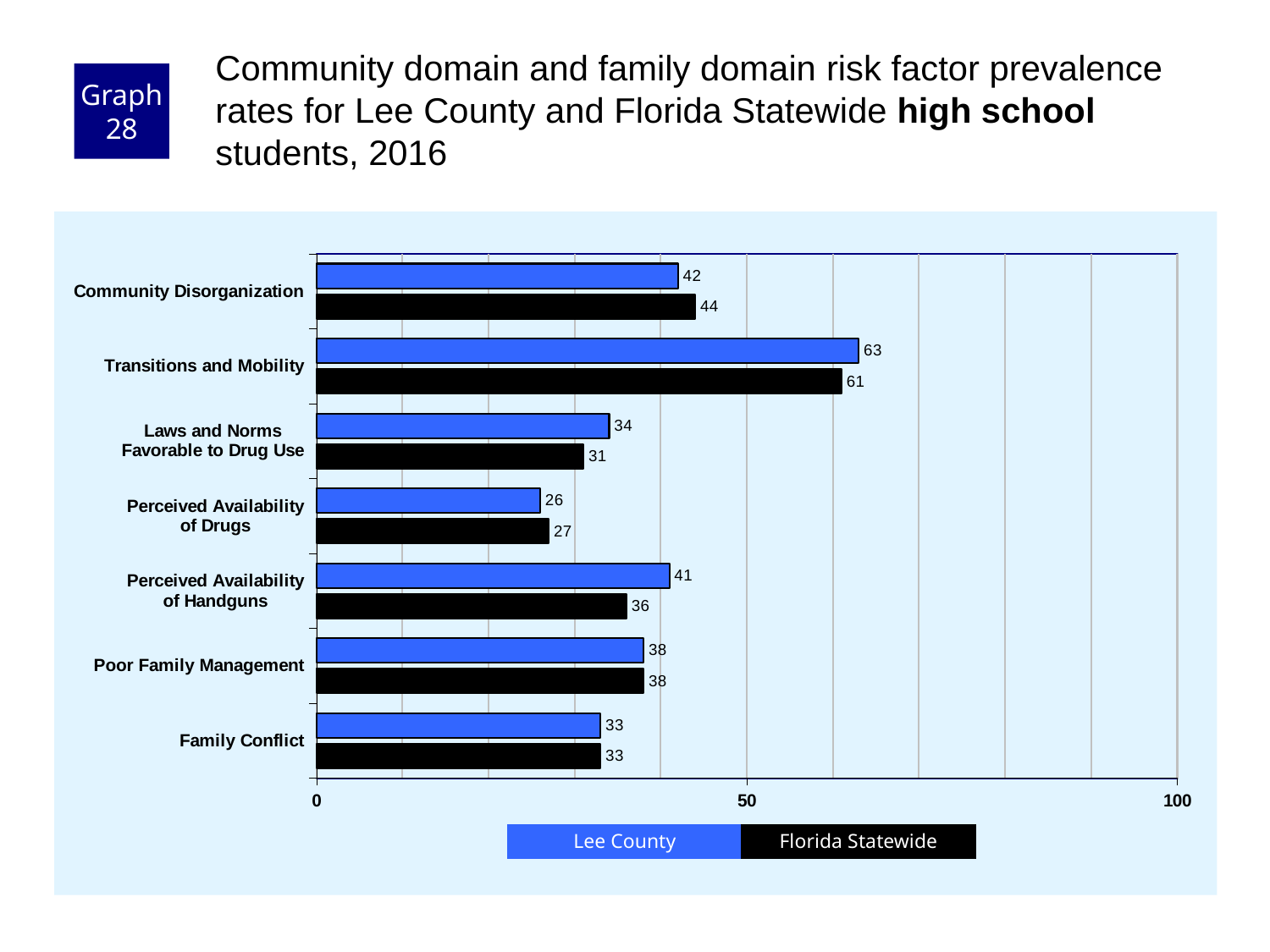
Is the Florida Statewide value for Transitions and Mobility greater or less than 50? greater Which risk factor has the lowest Florida Statewide value? Perceived Availability of Drugs Which colour represents Florida Statewide in the chart? Black What kind of chart is shown on the slide? Bar chart How many risk factor categories are shown on the chart? 7 What is the difference between the Lee County and Florida Statewide values for Perceived Availability of Handguns? 5 What is the Lee County value for Perceived Availability of Handguns? 41 What is the Florida Statewide value for Perceived Availability of Drugs? 27 Which risk factor has the highest Lee County value? Transitions and Mobility How many series does the legend list? 2 Which is larger for Community Disorganization: the Lee County value or the Florida Statewide value? Florida Statewide What is the Lee County value for Transitions and Mobility? 63